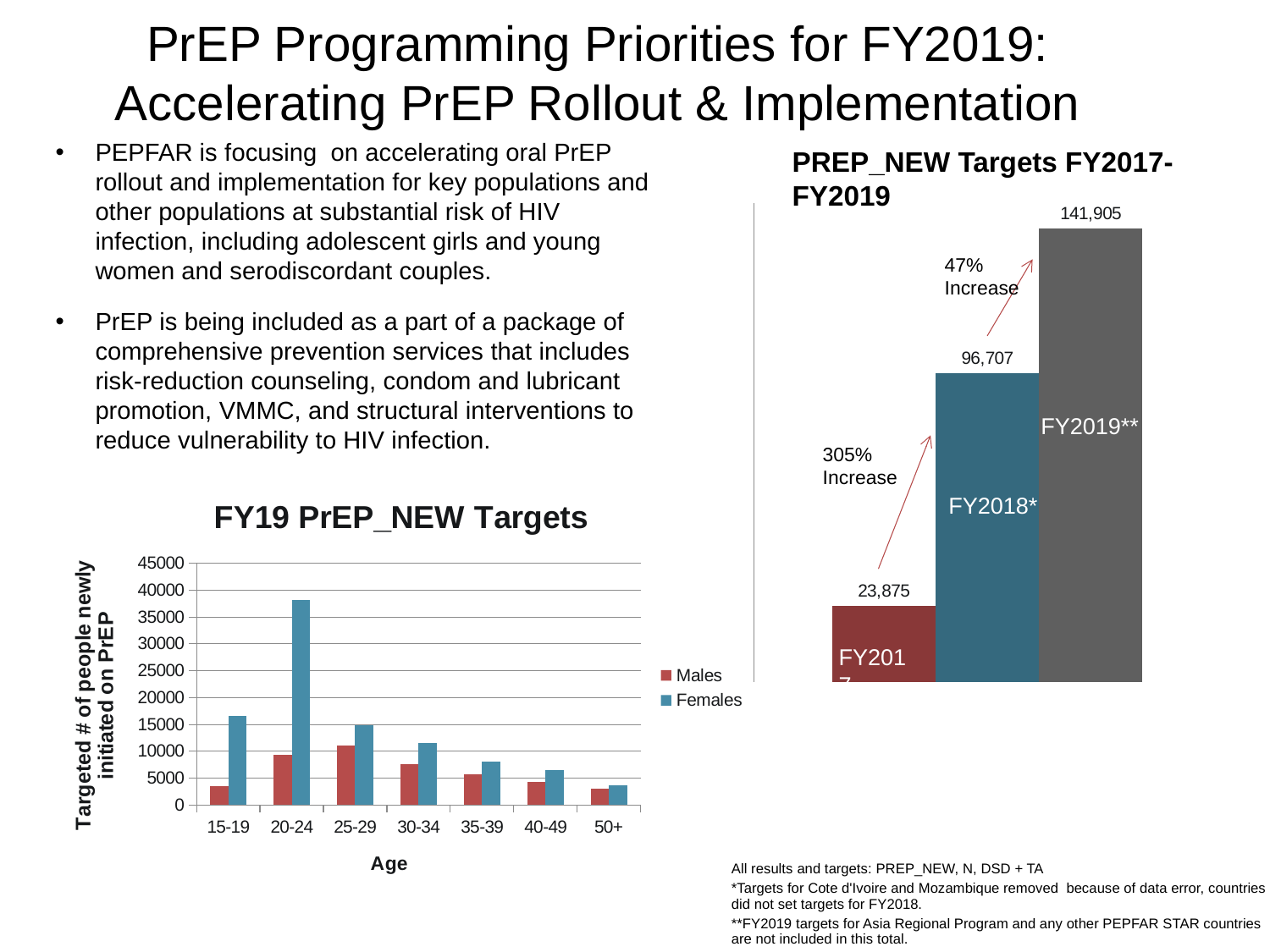
In the FY19 PrEP_NEW Targets chart, is the Females value for 20-24 greater or less than 35000? greater In the FY19 PrEP_NEW Targets chart, is the Males value for 50+ greater or less than 5000? less In the PREP_NEW Targets FY2017-FY2019 chart, how many fiscal years are plotted? 3 In the PREP_NEW Targets FY2017-FY2019 chart, what is the difference between the FY2019 and FY2018 targets? 45,198 In the PREP_NEW Targets FY2017-FY2019 chart, what is the target value for FY2018? 96,707 In the FY19 PrEP_NEW Targets chart, how many series does the legend list? 2 In the PREP_NEW Targets FY2017-FY2019 chart, what is the target value for FY2019? 141,905 In the PREP_NEW Targets FY2017-FY2019 chart, what is the target value for FY2017? 23,875 In the PREP_NEW Targets FY2017-FY2019 chart, which fiscal year has the highest target? FY2019 In the PREP_NEW Targets FY2017-FY2019 chart, what percentage increase is shown between FY2017 and FY2018? 305% In the FY19 PrEP_NEW Targets chart, which age group has the highest Females value? 20-24 In the FY19 PrEP_NEW Targets chart, how many age groups are shown on the x axis? 7